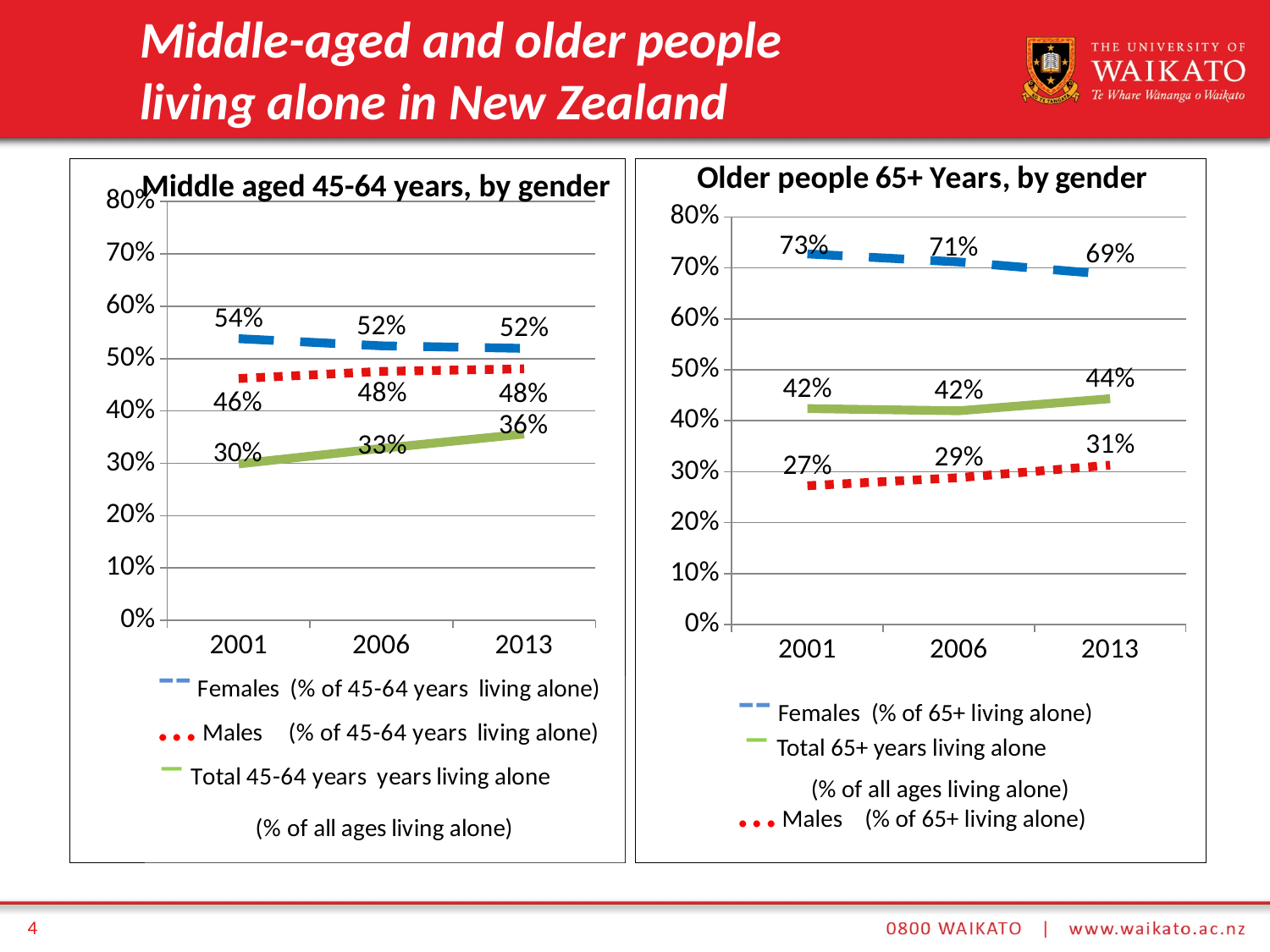
In the 'Older people 65+ Years, by gender' chart, what is the value for Females in 2013? 69% In the 'Middle aged 45-64 years, by gender' chart, how many series does the legend list? 3 In the 'Middle aged 45-64 years, by gender' chart, what is the value for Females in 2001? 54% In the 'Middle aged 45-64 years, by gender' chart, what is the value for Males in 2006? 48% In the 'Older people 65+ Years, by gender' chart, what is the difference between Females and Males in 2013? 38% In the 'Older people 65+ Years, by gender' chart, does the Females series rise or fall from 2001 to 2013? fall What type of chart is the 'Older people 65+ Years, by gender' chart? line chart In the 'Middle aged 45-64 years, by gender' chart, does the Total 45-64 years living alone series rise or fall from 2001 to 2013? rise In the 'Middle aged 45-64 years, by gender' chart, what is the value for Total 45-64 years living alone in 2013? 36% In the 'Older people 65+ Years, by gender' chart, what is the value for Males in 2001? 27% In the 'Older people 65+ Years, by gender' chart, in which year is the Females value highest? 2001 In the 'Middle aged 45-64 years, by gender' chart, what is the difference between Females and Males in 2001? 8%